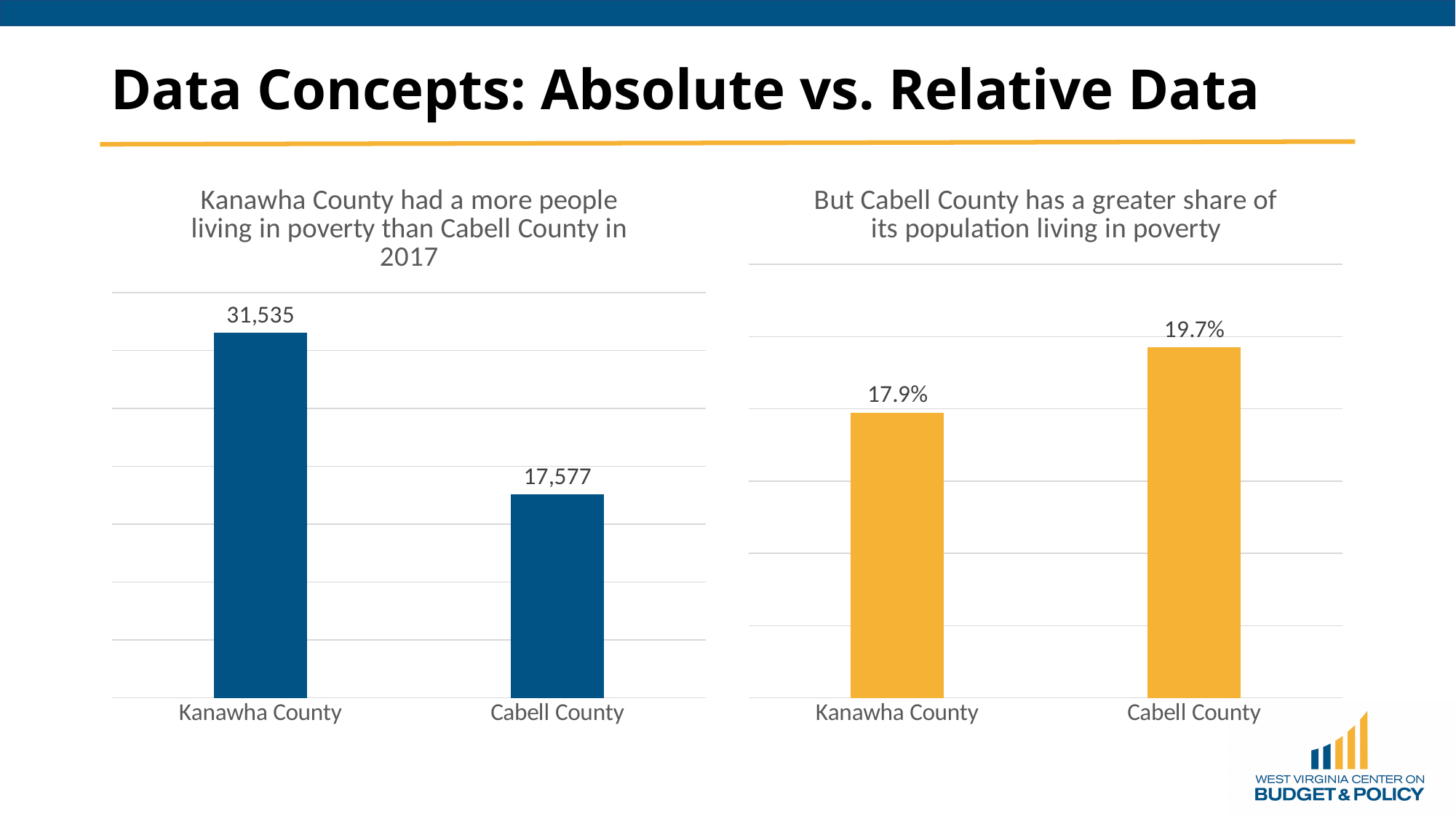
In the right chart, what share of Kanawha County's population is living in poverty? 17.9% In the left chart, what is the difference between the number of people in poverty in Kanawha County and Cabell County? 13,958 In the left chart, how many people were living in poverty in Kanawha County in 2017? 31,535 In the right chart, how many percentage points higher is Cabell County's poverty share than Kanawha County's? 1.8 What colour are the bars in the right chart? Yellow In the right chart, which county has the lower share of its population living in poverty? Kanawha County What type of chart is the right chart? Bar chart In the right chart, is the poverty share larger for Cabell County or Kanawha County? Cabell County In the left chart, how many people were living in poverty in Cabell County in 2017? 17,577 In the left chart, which county has the higher number of people living in poverty? Kanawha County How many categories are shown in the left chart? 2 In the right chart, what share of Cabell County's population is living in poverty? 19.7%